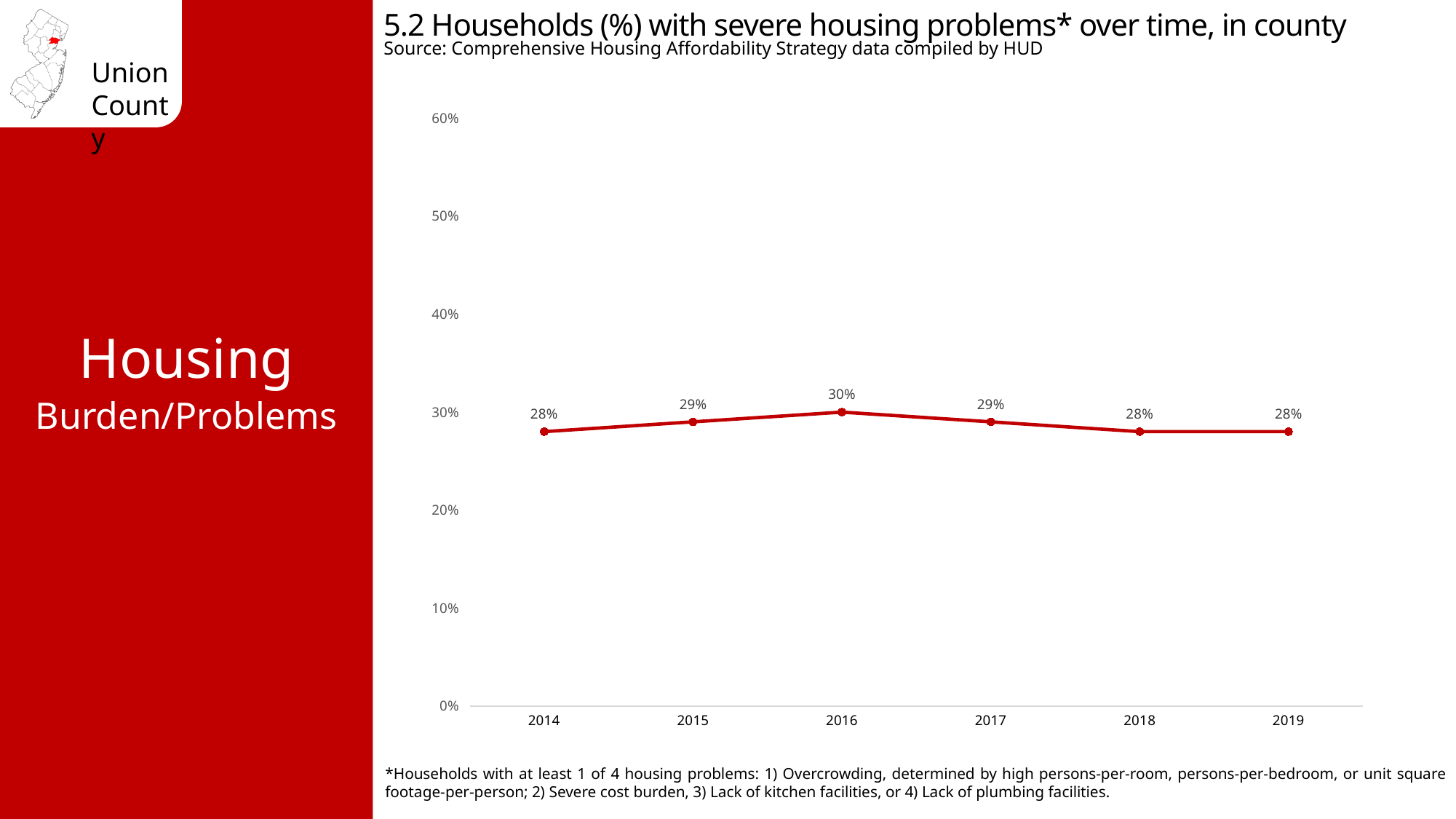
Is the value for 2015 higher or lower than the value for 2016? lower What type of chart is shown on the slide? line chart What is the source of the data cited under the chart title? Comprehensive Housing Affordability Strategy data compiled by HUD What percentage of households had severe housing problems in 2016? 30% Does the value rise or fall from 2016 to 2018? fall How many years are plotted on the chart? 6 What is the value shown for 2019? 28% Which year has the highest percentage of households with severe housing problems? 2016 What is the value shown for 2014? 28% What is the highest value shown on the y-axis? 60% Is the value for 2017 greater or less than 40%? less What is the difference between the 2016 value and the 2014 value? 2%